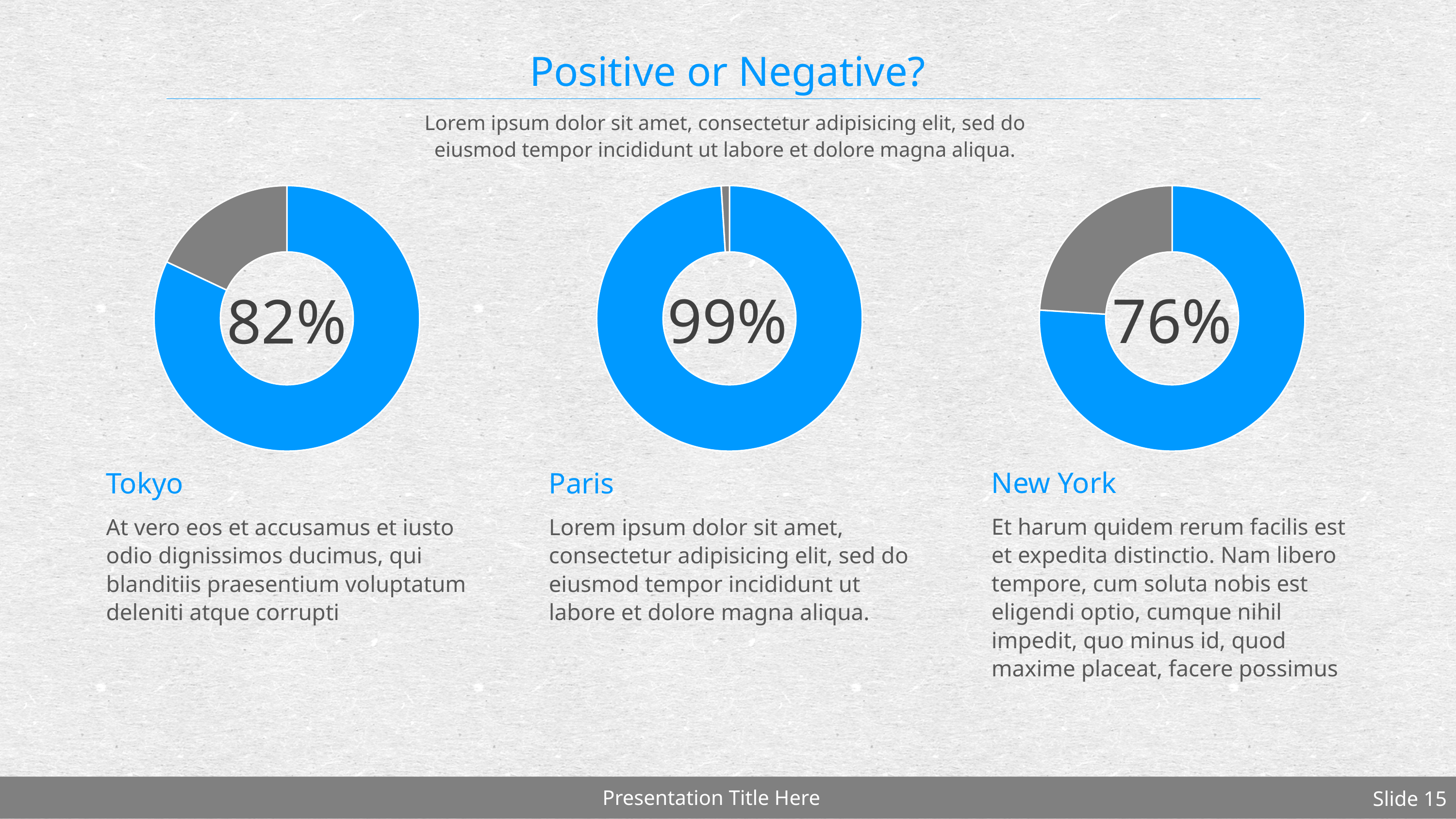
What percentage is shown in the centre of the Paris donut chart? 99% What is the difference between the percentages shown for Tokyo and New York? 6% What percentage is shown in the centre of the Tokyo donut chart? 82% What percentage is shown in the centre of the New York donut chart? 76% What colour is the slice representing the percentage shown in each donut chart? Blue Which city's donut chart shows the highest percentage? Paris What is the difference between the percentages shown for Paris and New York? 23% Which is larger, the percentage shown for Tokyo or the percentage shown for New York? Tokyo What kind of chart is used for each city on this slide? Donut chart Which city's donut chart shows the lowest percentage? New York How many donut charts are on the slide? 3 In the Tokyo donut chart, what share of the ring is the grey slice? 18%